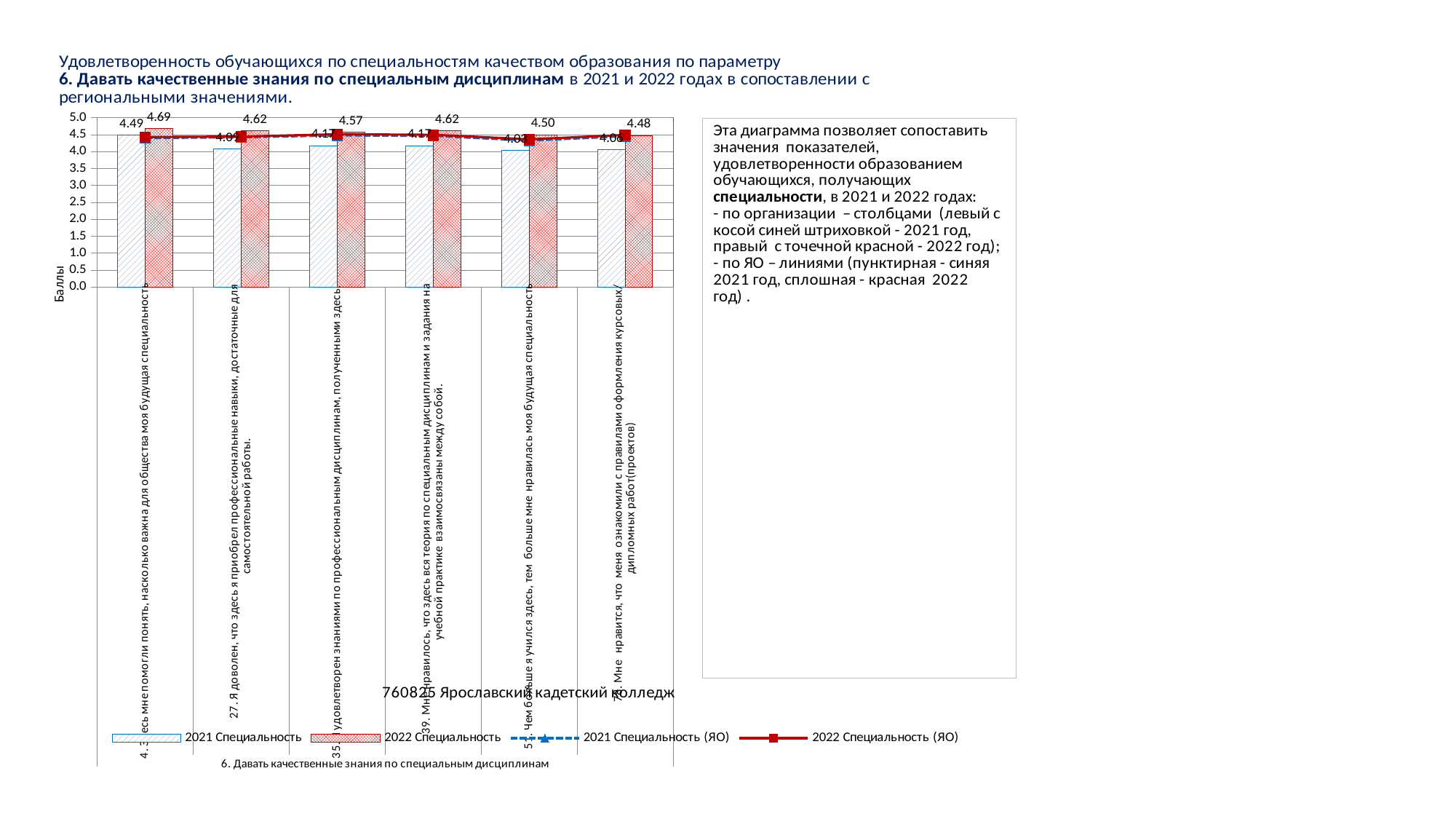
What is the title of the vertical axis? Баллы How many categories are shown on the x axis? 6 Which category has the lowest 2022 Специальность value? The last (sixth) category, 4.48 What is the value of the 2022 Специальность bar for the second category (question 27)? 4.62 What is the value of the 2021 Специальность bar for the third category (question 35)? 4.17 What is the value of the 2022 Специальность bar for the first category (question 4)? 4.69 What is the value of the 2022 Специальность bar for the last (sixth) category? 4.48 Is the 2021 Специальность value for the second category (question 27) greater or less than 4.5? less Which category has the highest 2022 Специальность value? The first category (question 4), 4.69 For the third category (question 35), which is larger: the 2021 Специальность bar or the 2022 Специальность bar? 2022 Специальность (4.57) What is the difference between the 2022 and 2021 Специальность values for the first category (question 4)? 0.20 How many series does the legend list? 4